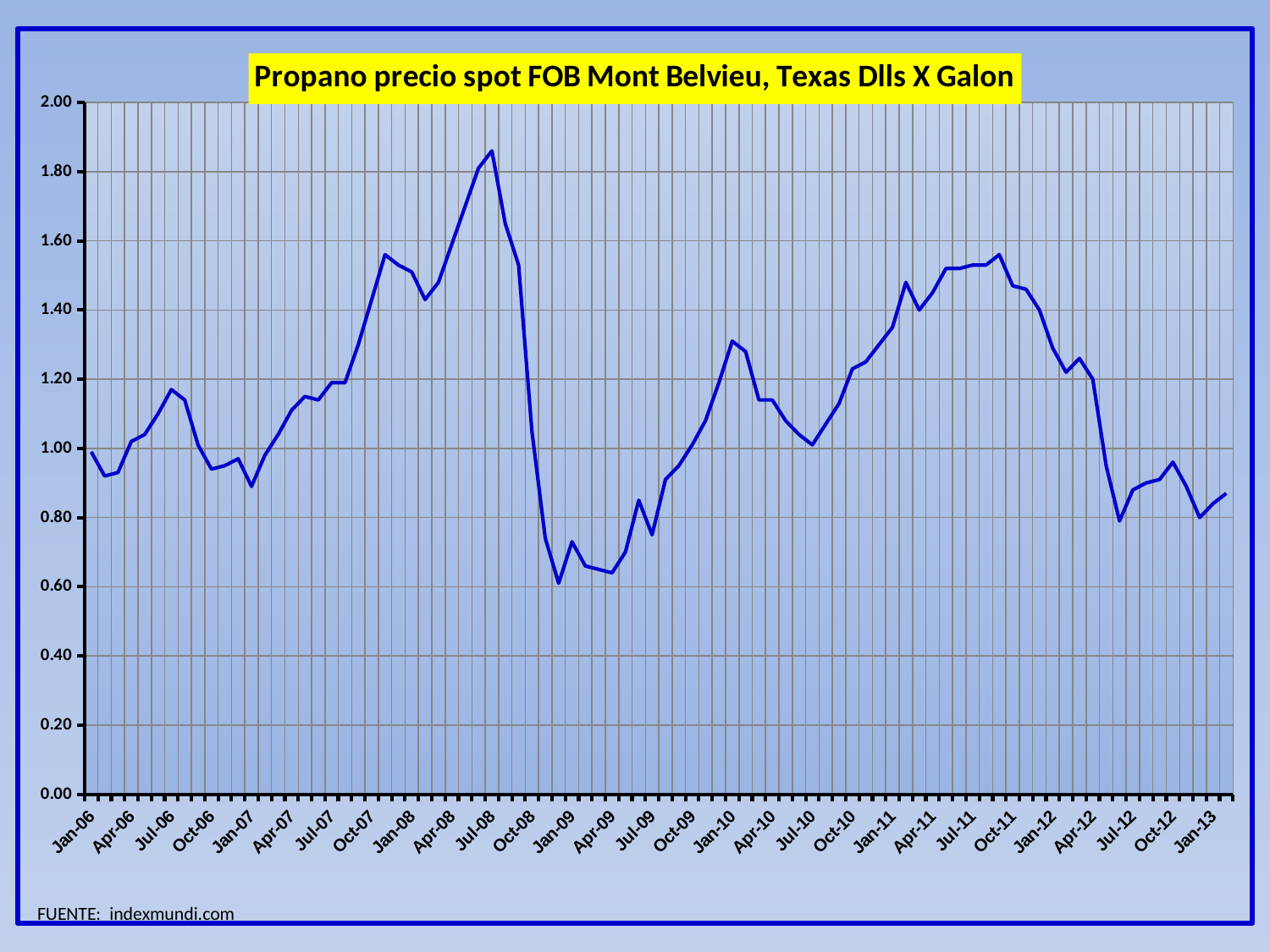
Is the value at Jul-08 greater or less than 1.60? greater Does the propane price rise or fall between Jan-09 and Jan-10? rise What is the title of the chart? Propano precio spot FOB Mont Belvieu, Texas Dlls X Galon Does the propane price rise or fall between Jul-08 and Jan-09? fall How many data series are plotted in the chart? 1 Which is higher, the value at Jul-08 or the value at Jul-11? Jul-08 Around which x-axis label does the propane price reach its highest point? Jul-08 Around which x-axis label does the propane price reach its lowest point? Jan-09 Is the value at Apr-09 greater or less than 0.80? less Is the value at Jan-10 greater or less than 1.20? greater What kind of chart is shown on the slide? Line chart